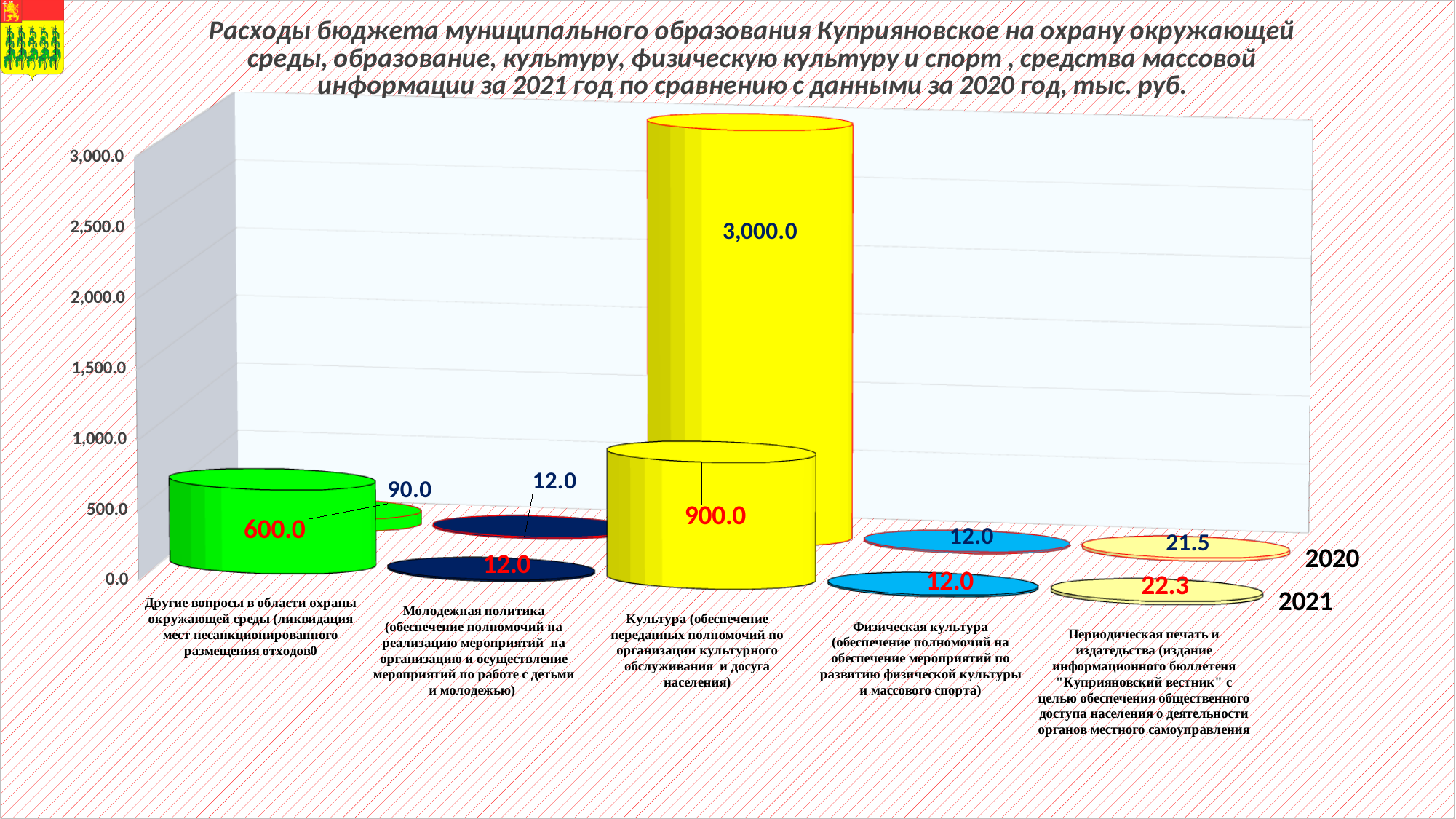
What is the 2021 value for Культура? 900.0 Which is larger for Культура: the 2020 value or the 2021 value? 2020 What is the 2020 value for Культура? 3,000.0 How many categories are shown on the x axis? 5 What is the 2021 value for Другие вопросы в области охраны окружающей среды? 600.0 What is the 2021 value for Периодическая печать и издательства? 22.3 Which category has the highest 2020 value? Культура What is the 2020 value for Другие вопросы в области охраны окружающей среды? 90.0 What is the difference between the 2021 and 2020 values for Другие вопросы в области охраны окружающей среды? 510.0 What is the difference between the 2020 and 2021 values for Культура? 2,100.0 What is the 2020 value for Периодическая печать и издательства? 21.5 How many series does the chart show? 2